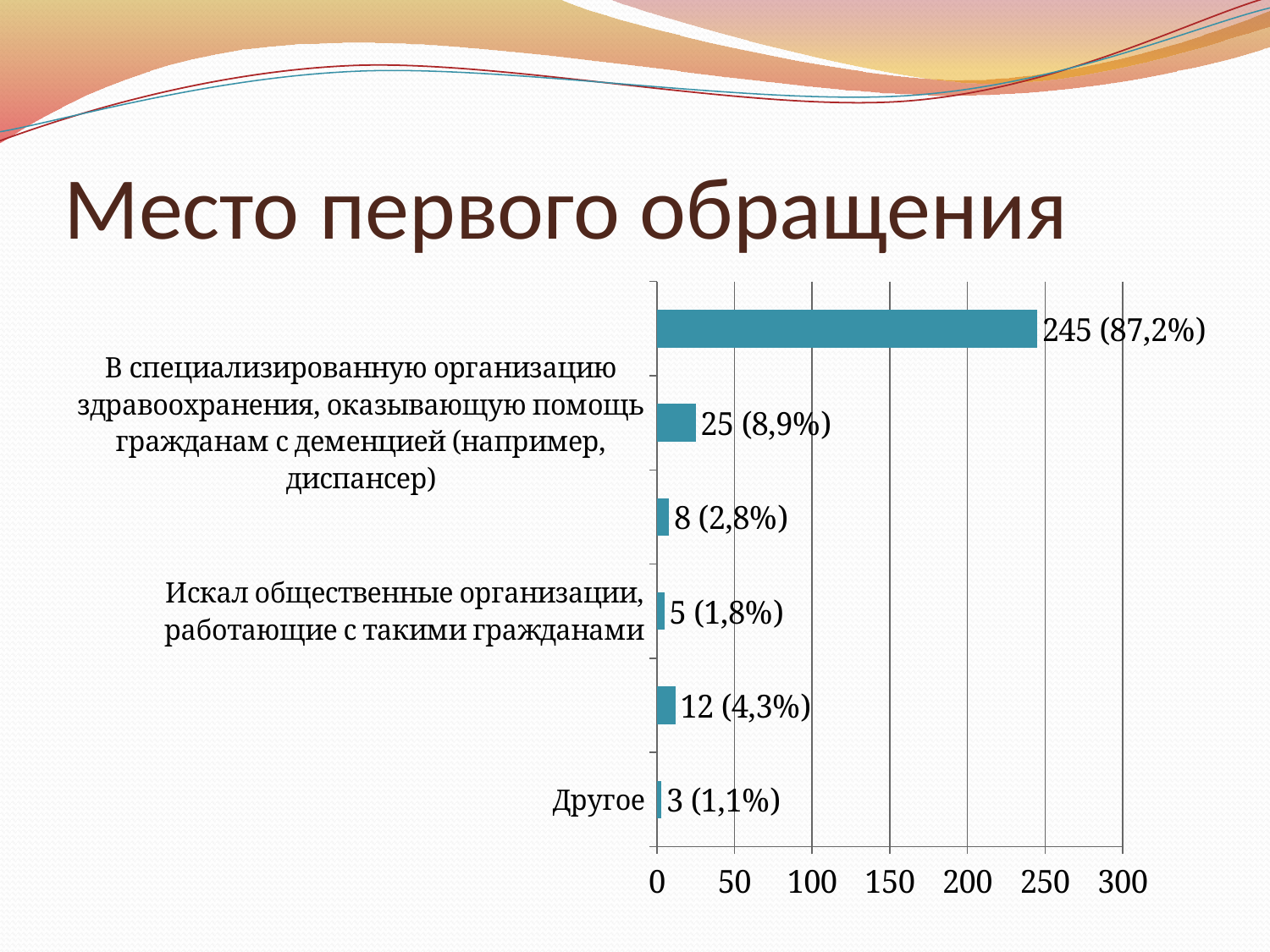
What is the data label on the bar for "Искал общественные организации, работающие с такими гражданами"? 5 (1,8%) What is the difference in count between "В специализированную организацию здравоохранения..." (25) and "Искал общественные организации..." (5)? 20 Is the value of the longest bar greater or less than 200? greater What is the data label on the bar for "Другое"? 3 (1,1%) How many bars are plotted in the chart? 6 Which is larger: the value for "Другое" or the value for "Искал общественные организации, работающие с такими гражданами"? Искал общественные организации, работающие с такими гражданами What kind of chart is shown on the slide? bar chart What is the data label on the longest bar in the chart? 245 (87,2%) What is the title of the slide chart? Место первого обращения Which labelled category has the lowest value in the chart? Другое What is the maximum value shown on the horizontal axis? 300 What is the data label on the bar for "В специализированную организацию здравоохранения, оказывающую помощь гражданам с деменцией (например, диспансер)"? 25 (8,9%)